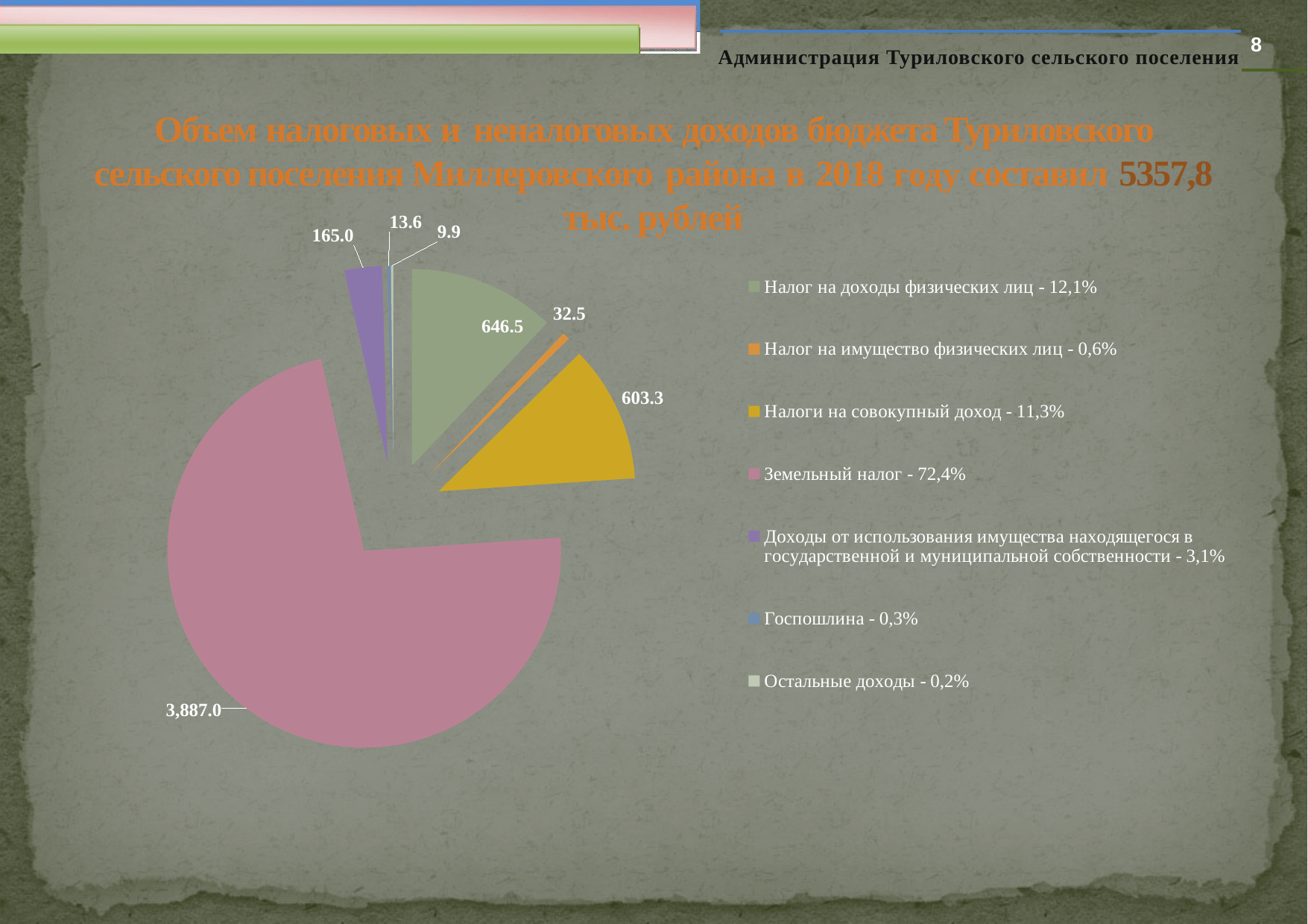
What is the value shown for Налоги на совокупный доход? 603.3 How many slices does the pie chart have? 7 What is the difference between the values for Налог на доходы физических лиц and Налоги на совокупный доход? 43.2 Which is larger: the value for Доходы от использования имущества находящегося в государственной и муниципальной собственности or the value for Налог на имущество физических лиц? Доходы от использования имущества находящегося в государственной и муниципальной собственности What is the value shown for Налог на доходы физических лиц? 646.5 What share of the pie does Земельный налог represent according to the legend? 72,4% Which category has the smallest slice of the pie? Остальные доходы What is the value shown for Земельный налог? 3,887.0 What type of chart is shown on the slide? pie chart Which category has the largest slice of the pie? Земельный налог How many entries does the legend of the pie chart list? 7 What is the value shown for Госпошлина? 13.6